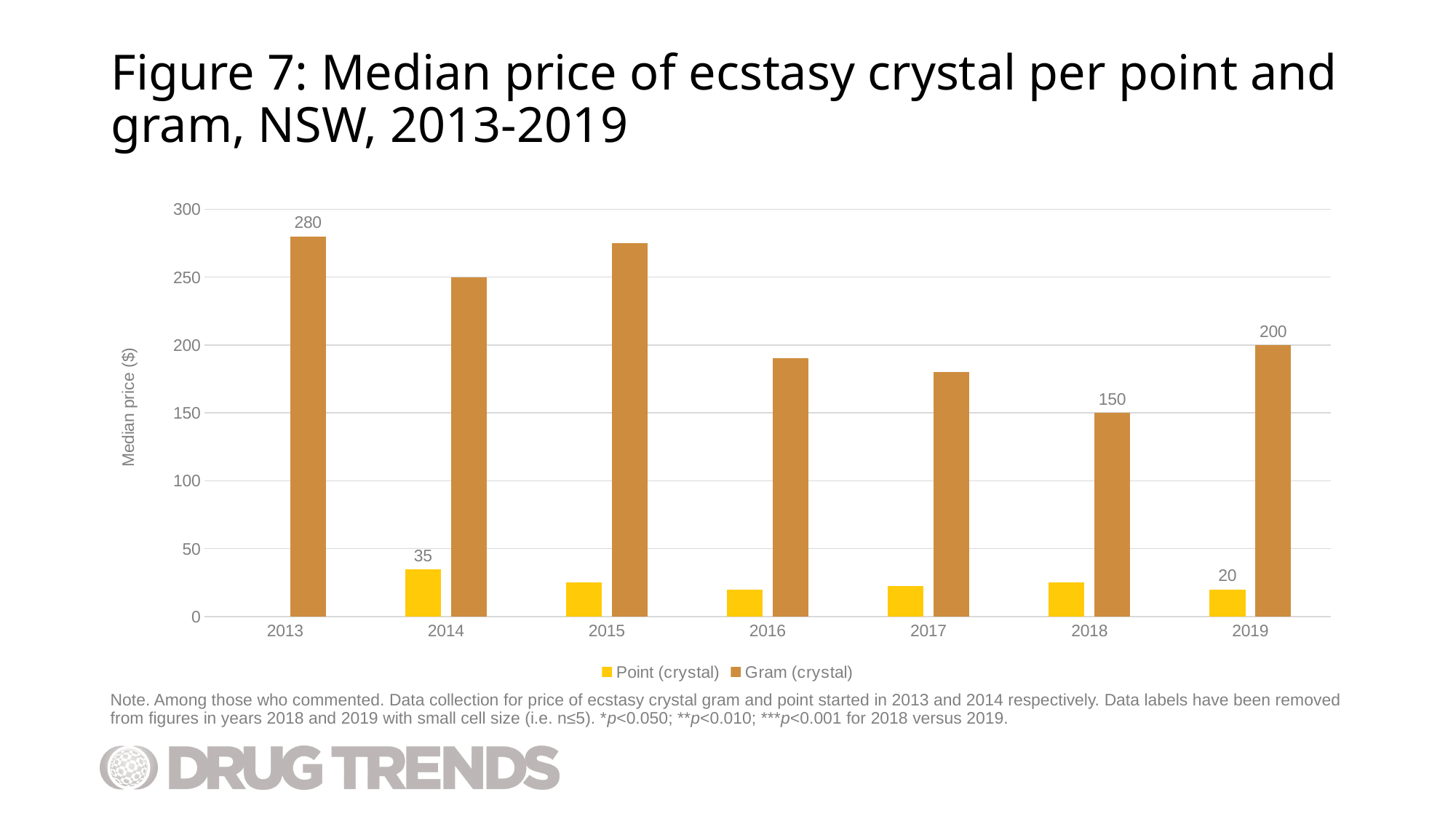
Which is larger: the median price per point in 2014 or in 2019? 2014 What is the median price per point of ecstasy crystal in 2019? 20 What is the difference between the median price per gram in 2013 and in 2019? 80 What is the median price per point of ecstasy crystal in 2014? 35 How many years are shown on the x axis? 7 Is the median price per gram in 2016 greater or less than 150? greater In which year is the median price per point (Point (crystal)) highest? 2014 What is the median price per gram of ecstasy crystal in 2018? 150 What is the median price per gram of ecstasy crystal in 2013? 280 How many series does the legend list? 2 What is the median price per gram of ecstasy crystal in 2019? 200 In which year is the median price per gram (Gram (crystal)) lowest? 2018